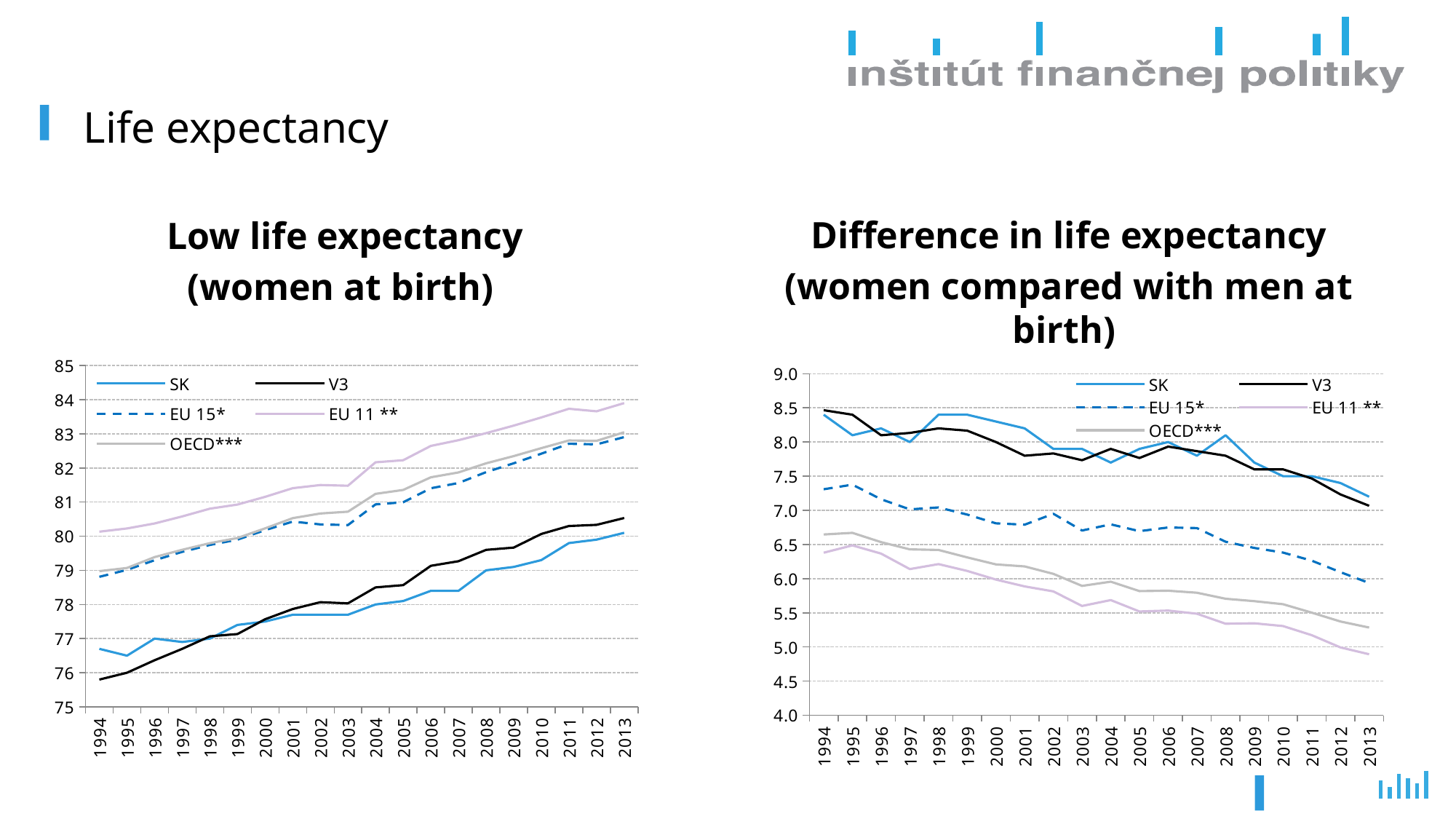
How many years are shown on the x axis of the 'Low life expectancy (women at birth)' chart? 20 How many series does the legend of the 'Low life expectancy (women at birth)' chart list? 5 In the 'Difference in life expectancy (women compared with men at birth)' chart, do the values generally rise or fall from 1994 to 2013? fall In the 'Low life expectancy (women at birth)' chart, is the value for V3 in 1994 greater or less than 76? less In the 'Low life expectancy (women at birth)' chart, which is higher in 1994, SK or V3? SK What kind of chart is the 'Difference in life expectancy (women compared with men at birth)' chart? line chart In the 'Difference in life expectancy (women compared with men at birth)' chart, which series has the lowest value in 2013? EU 11 ** In the 'Difference in life expectancy (women compared with men at birth)' chart, is the value for EU 15* in 1994 greater or less than 7.0? greater In the 'Low life expectancy (women at birth)' chart, which series has the highest value in 2013? EU 11 ** In the 'Low life expectancy (women at birth)' chart, do the values generally rise or fall from 1994 to 2013? rise In the 'Low life expectancy (women at birth)' chart, which series has the lowest value in 2013? SK What kind of chart is the 'Low life expectancy (women at birth)' chart? line chart